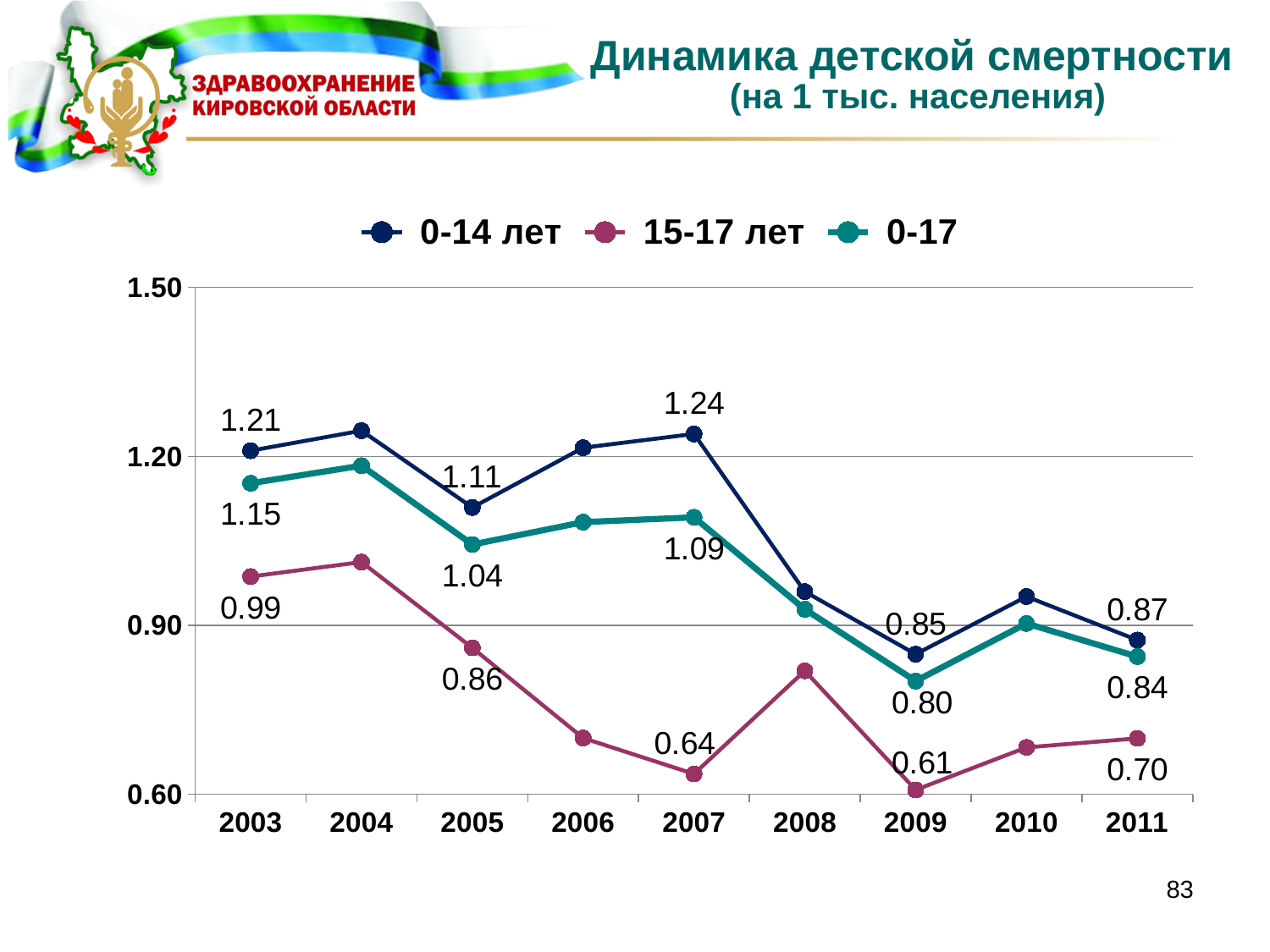
What is the value for the 0-17 series in 2003? 1.15 What kind of chart is shown on the slide? line chart Which is larger in 2009: the 0-14 лет value or the 15-17 лет value? 0-14 лет What is the value for the 0-14 лет series in 2007? 1.24 What is the difference between the 0-14 лет value and the 0-17 value in 2005? 0.07 How many years are shown on the x axis? 9 How many series does the legend list? 3 Is the value for the 0-14 лет series in 2004 greater or less than 1.20? greater What is the value for the 15-17 лет series in 2009? 0.61 Is the value for the 15-17 лет series in 2008 greater or less than 0.90? less What is the difference between the 0-14 лет value in 2007 and in 2011? 0.37 What is the value for the 15-17 лет series in 2011? 0.70